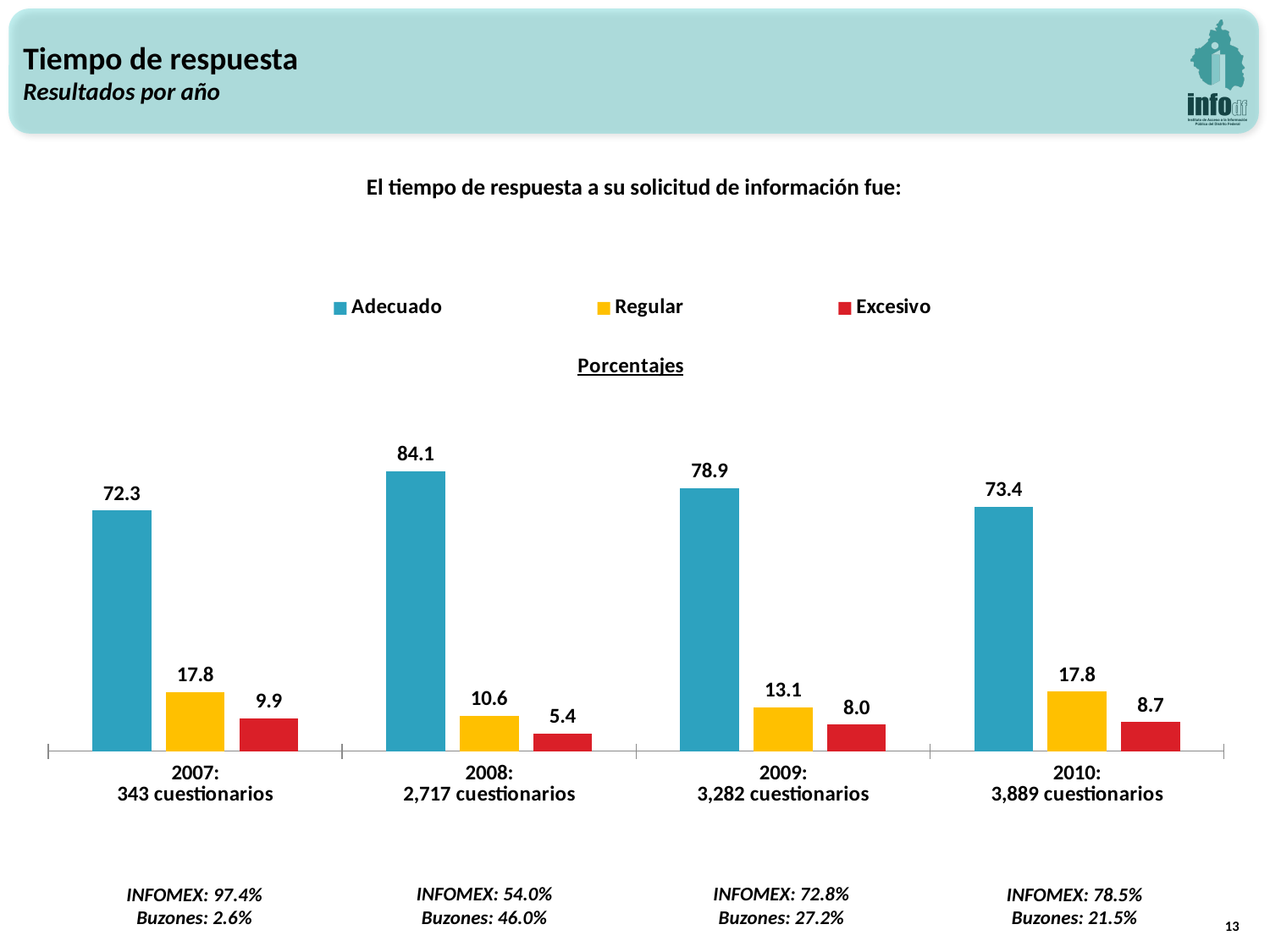
In which year is the Adecuado value highest? 2008 Which is larger, the Regular value for 2009 or the Regular value for 2008? 2009 In which year is the Excesivo value lowest? 2008 What is the value for Excesivo in 2009? 8.0 Does the Adecuado value rise or fall from 2008 to 2010? fall What kind of chart is shown on the slide? bar chart What is the value for Adecuado in 2008? 84.1 What is the value for Regular in 2010? 17.8 Which legend entry is shown in red? Excesivo How many year categories are shown on the x axis? 4 How many series does the legend list? 3 What is the difference between the Adecuado values for 2008 and 2007? 11.8